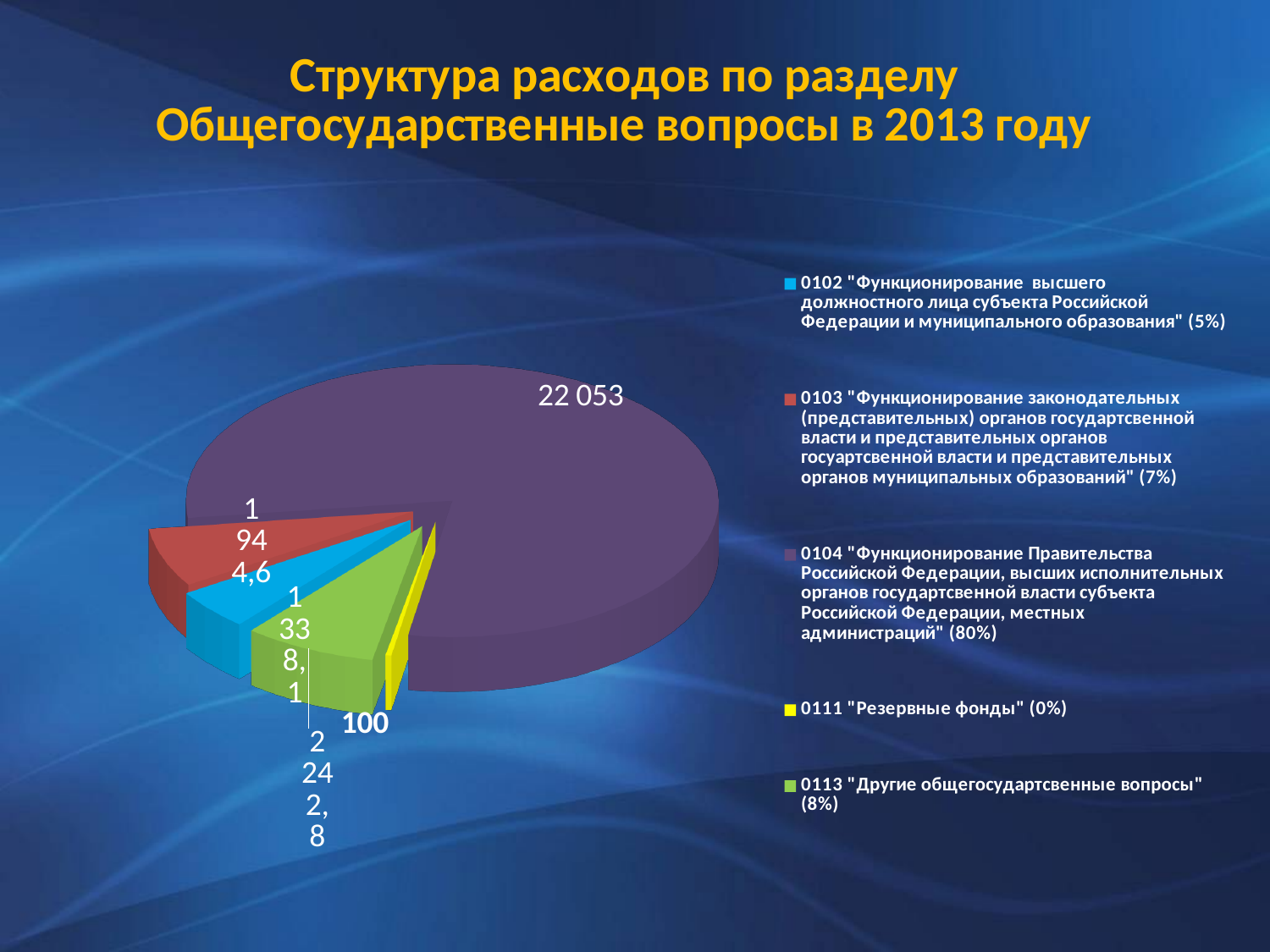
What is the difference between the value for category 0104 (22 053) and the value for category 0111 (100)? 21 953 Which has the larger share: category 0103 or category 0113? 0113 How many entries does the legend list? 5 How many slices does the pie chart have? 5 What share of the pie does 0113 "Другие общегосударственные вопросы" represent, according to the legend? 8% Which category has the smallest slice of the pie? 0111 "Резервные фонды" Which category has the largest slice of the pie? 0104 "Функционирование Правительства Российской Федерации, высших исполнительных органов государственной власти субъекта Российской Федерации, местных администраций" What value is labelled on the largest (purple) slice, for category 0104? 22 053 What kind of chart is shown on the slide? pie chart What share of the pie does category 0104 represent, according to the legend? 80% What value is labelled on the slice for 0111 "Резервные фонды"? 100 What share of the pie does category 0102 represent, according to the legend? 5%